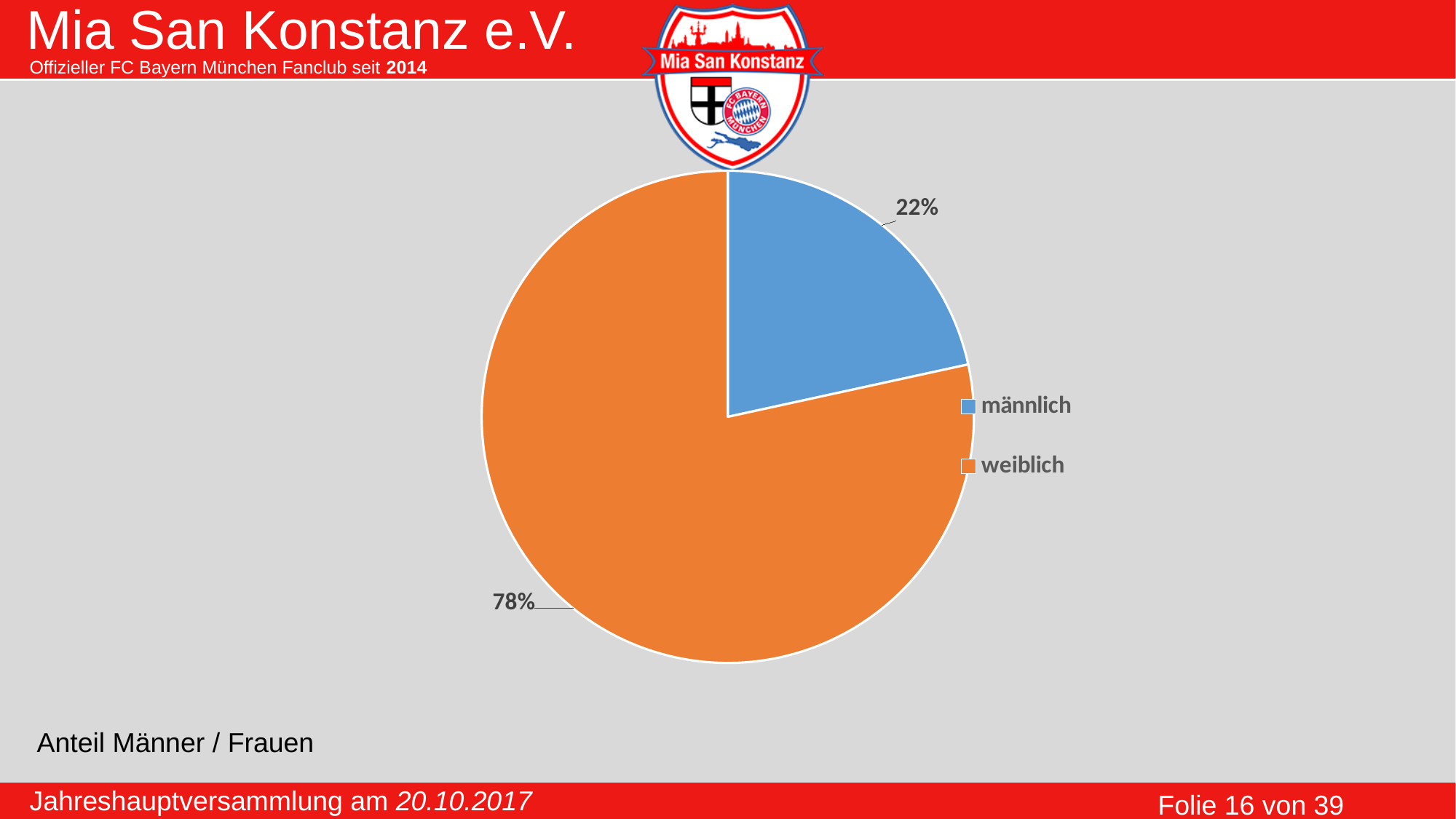
Which category has the smallest slice of the pie? männlich What share of the pie does the männlich slice represent? 22% Which slice is larger, männlich or weiblich? weiblich What colour is the weiblich slice? orange How many entries does the legend list? 2 What share of the pie does the weiblich slice represent? 78% What kind of chart is shown on the slide? pie chart What colour is the männlich slice? blue Which category has the largest slice of the pie? weiblich How many slices does the pie chart have? 2 What is the difference in percentage points between the weiblich and männlich slices? 56